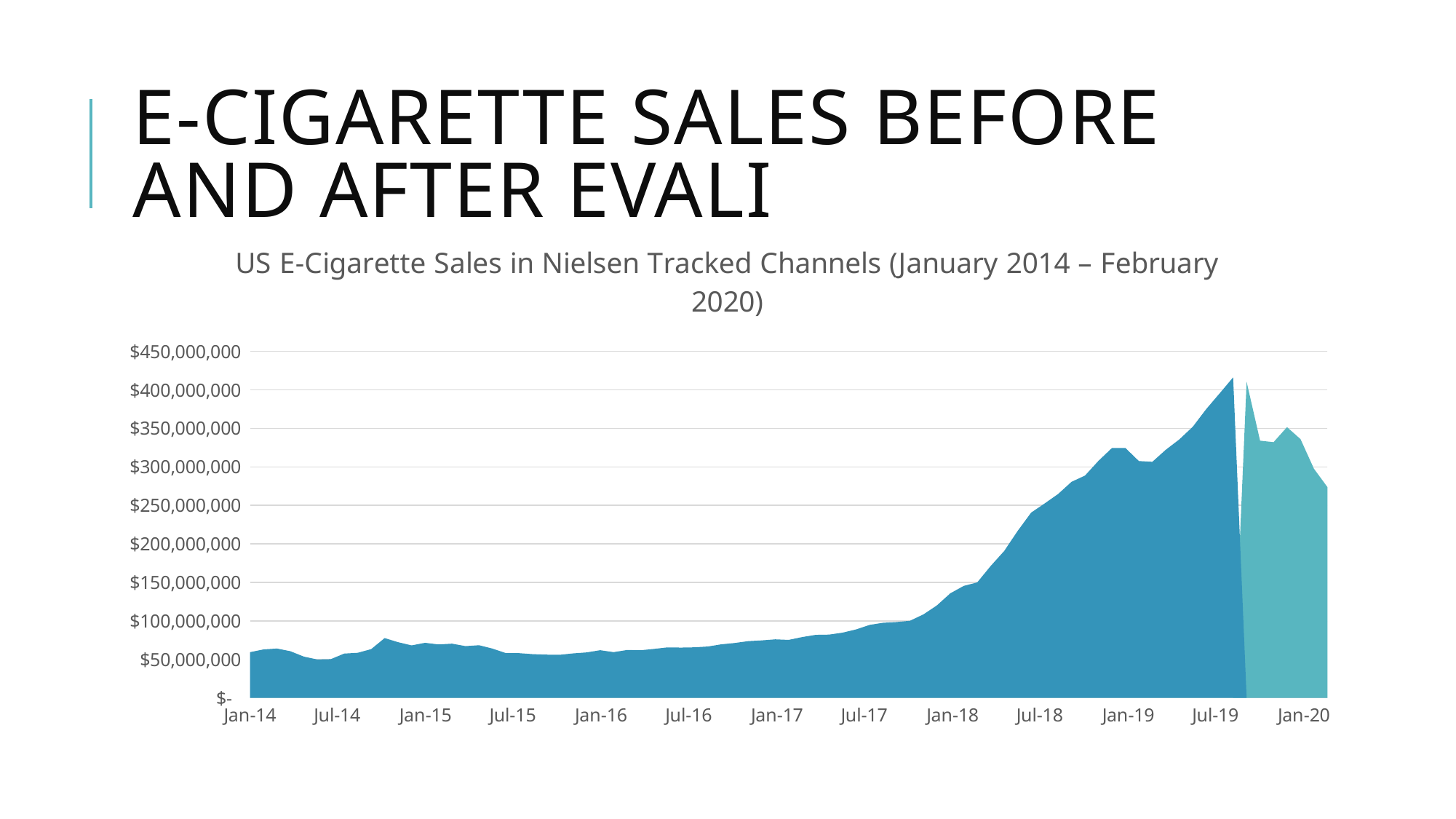
What kind of chart is shown on the slide? Area chart Is the value for Jan-14 greater or less than $100,000,000? less What is the title of the chart? US E-Cigarette Sales in Nielsen Tracked Channels (January 2014 – February 2020) Is the value for Jan-18 greater or less than $100,000,000? greater Do sales generally rise or fall from Jan-14 to Jul-19? Rise Which is larger, the value for Jan-14 or the value for Jan-20? Jan-20 Is the value for Jul-19 greater or less than $300,000,000? greater What is the highest value shown on the y-axis? $450,000,000 Which is larger, the value for Jan-19 or the value for Jul-19? Jul-19